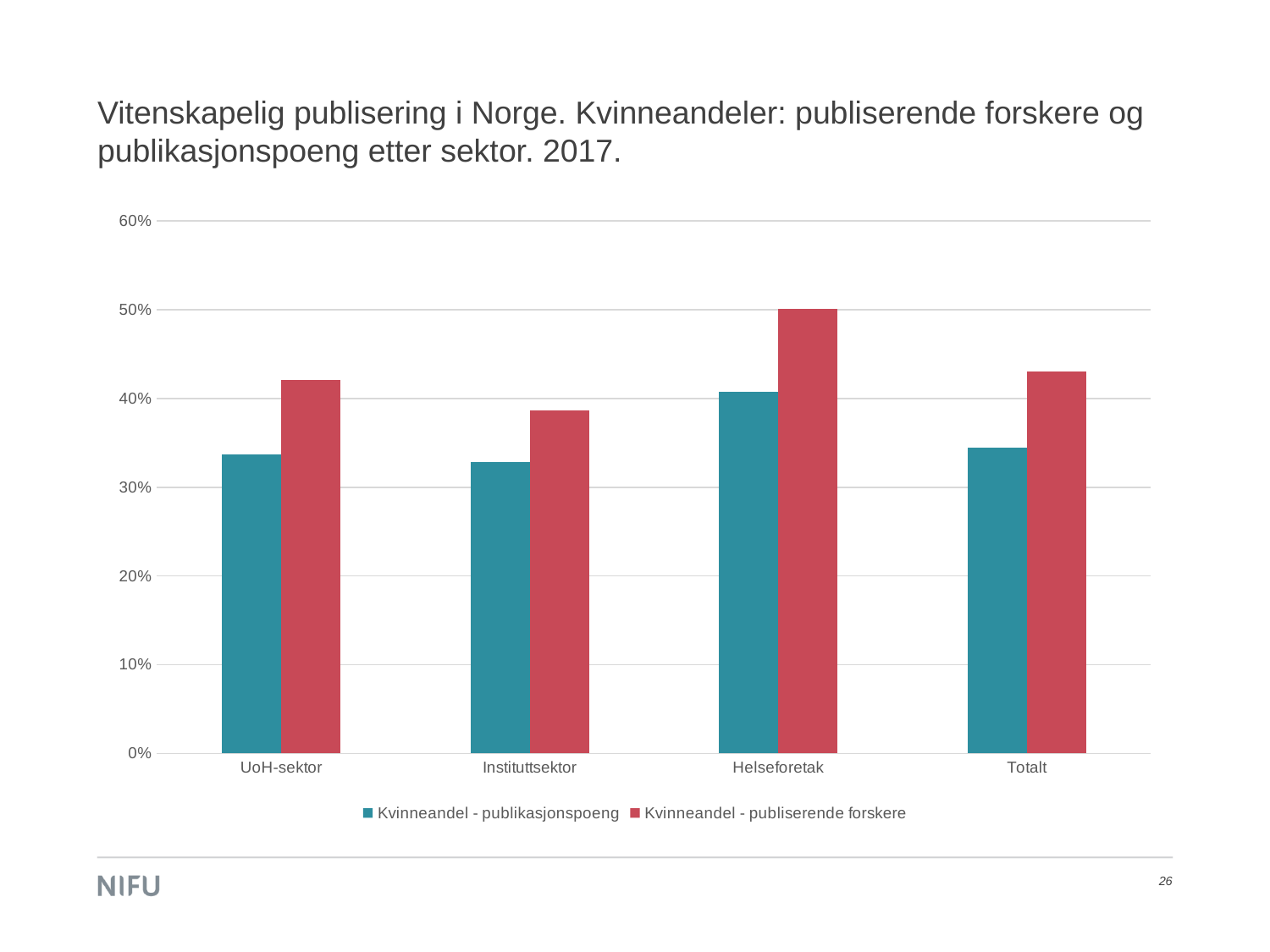
How many series does the legend list? 2 Is the value for Kvinneandel - publikasjonspoeng in Helseforetak greater or less than 50%? less How many sector categories are shown on the x axis? 4 Which category has the lowest value for Kvinneandel - publiserende forskere? Instituttsektor What kind of chart is shown on the slide? bar chart Which colour represents Kvinneandel - publiserende forskere in the legend? red For Totalt, which is larger: Kvinneandel - publikasjonspoeng or Kvinneandel - publiserende forskere? Kvinneandel - publiserende forskere Which category has the highest value for Kvinneandel - publikasjonspoeng? Helseforetak Is the value for Kvinneandel - publikasjonspoeng in UoH-sektor greater or less than 30%? greater For Helseforetak, which is larger: Kvinneandel - publikasjonspoeng or Kvinneandel - publiserende forskere? Kvinneandel - publiserende forskere Which category has the highest value for Kvinneandel - publiserende forskere? Helseforetak Is the value for Kvinneandel - publiserende forskere in Instituttsektor greater or less than 40%? less